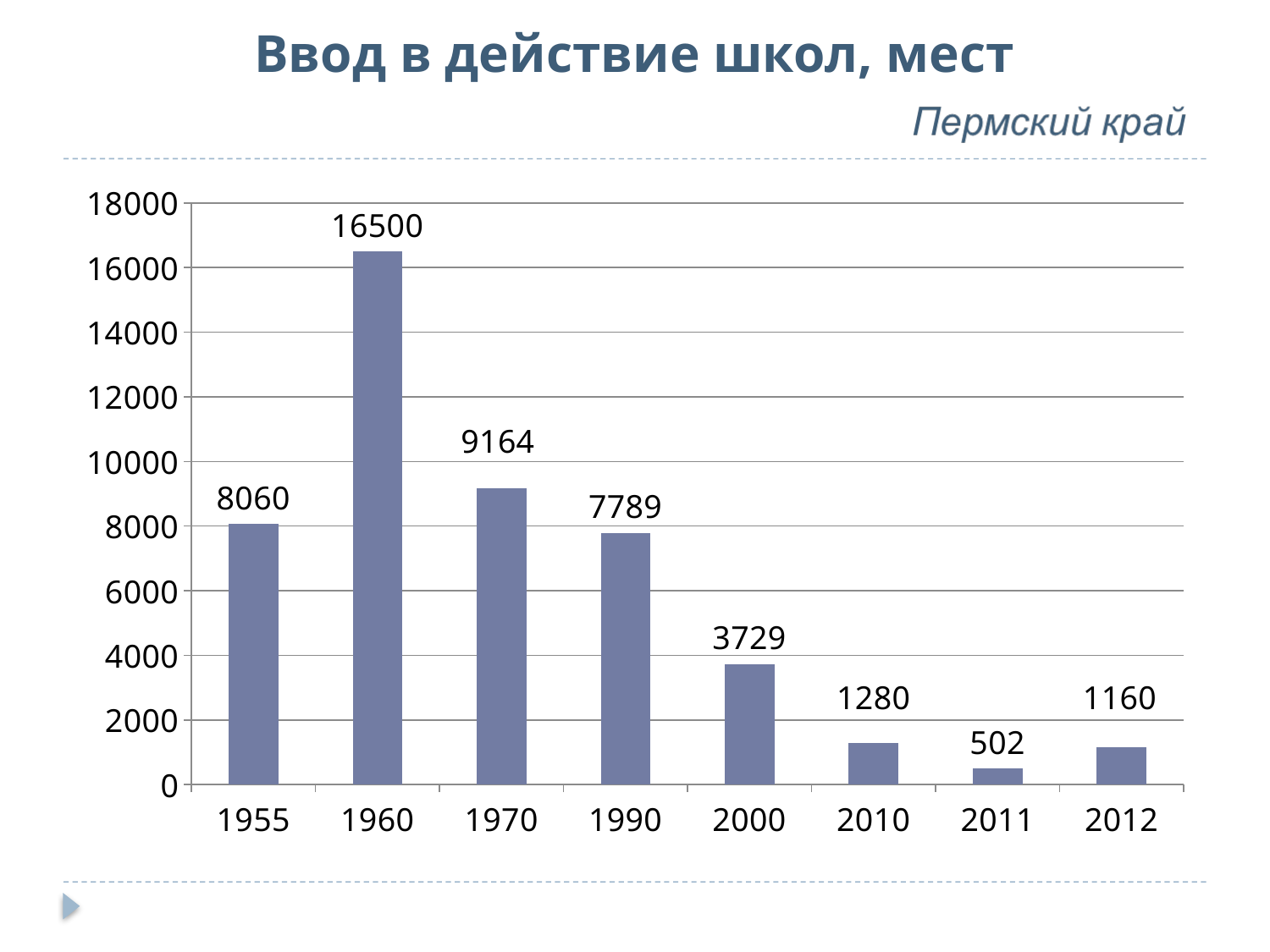
Which year has the lowest value? 2011 What kind of chart is shown on the slide? bar chart What is the title of the chart? Ввод в действие школ, мест Is the value for 2000 greater or less than 4000? less What is the difference between the values for 1970 and 1955? 1104 What is the difference between the values for 2012 and 2011? 658 What is the value for 1960? 16500 How many years are shown on the x axis? 8 Which year has the highest value? 1960 What is the value for 2011? 502 What is the value for 1990? 7789 Which is larger, the value for 2010 or the value for 2012? 2010